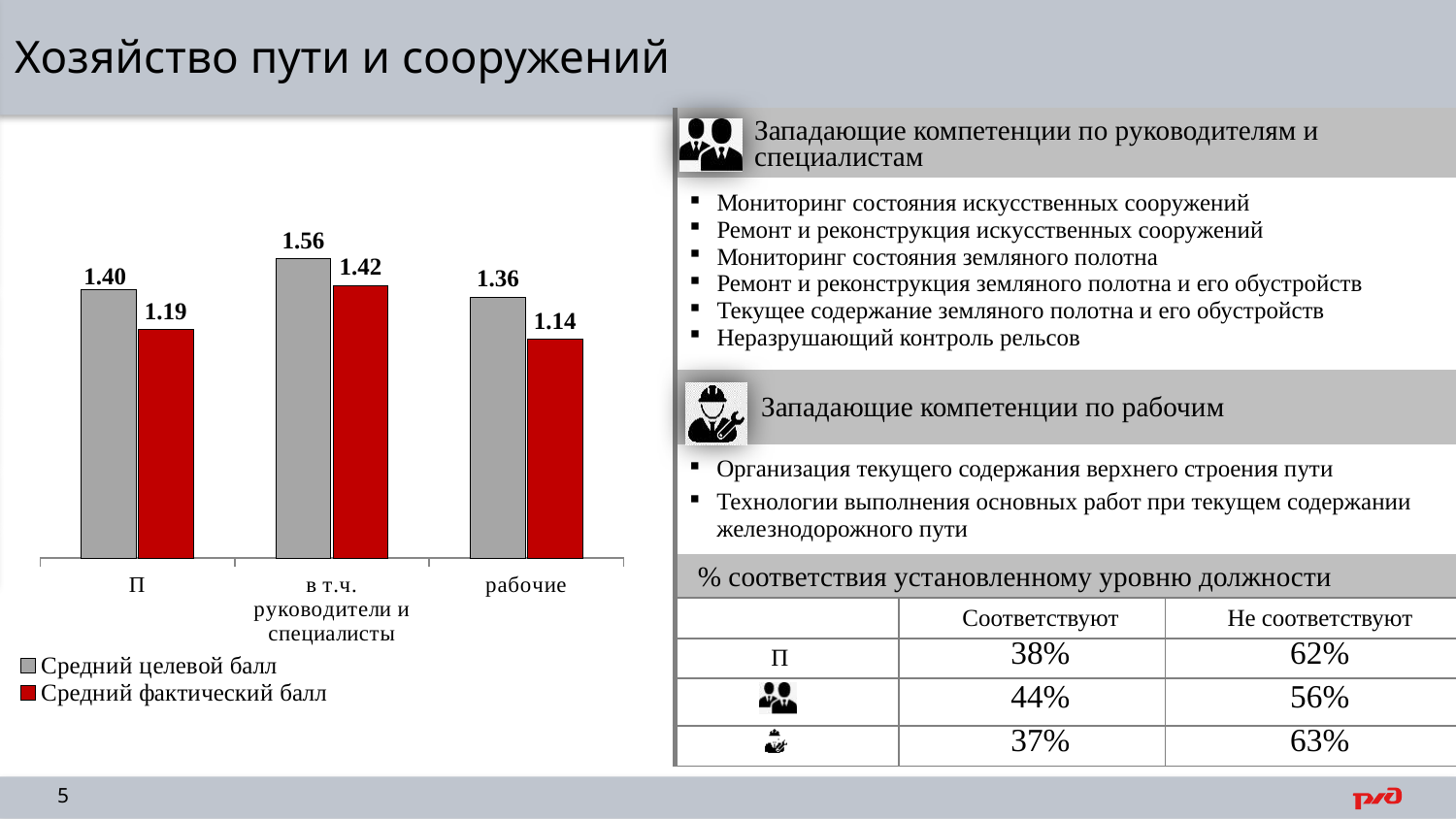
What is the value of "Средний фактический балл" for the category "П"? 1.19 What is the value of "Средний целевой балл" for "в т.ч. руководители и специалисты"? 1.56 What kind of chart is shown on the slide? bar chart Which is larger: "Средний фактический балл" for "в т.ч. руководители и специалисты" or "Средний целевой балл" for "рабочие"? Средний фактический балл for в т.ч. руководители и специалисты What is the value of "Средний фактический балл" for "рабочие"? 1.14 Which category has the highest "Средний целевой балл"? в т.ч. руководители и специалисты What is the difference between "Средний целевой балл" and "Средний фактический балл" for the category "П"? 0.21 How many categories are shown on the x axis of the chart? 3 Which category has the lowest "Средний фактический балл"? рабочие How many series does the chart legend list? 2 What is the difference between "Средний целевой балл" and "Средний фактический балл" for "рабочие"? 0.22 What is the value of "Средний целевой балл" for the category "П"? 1.40